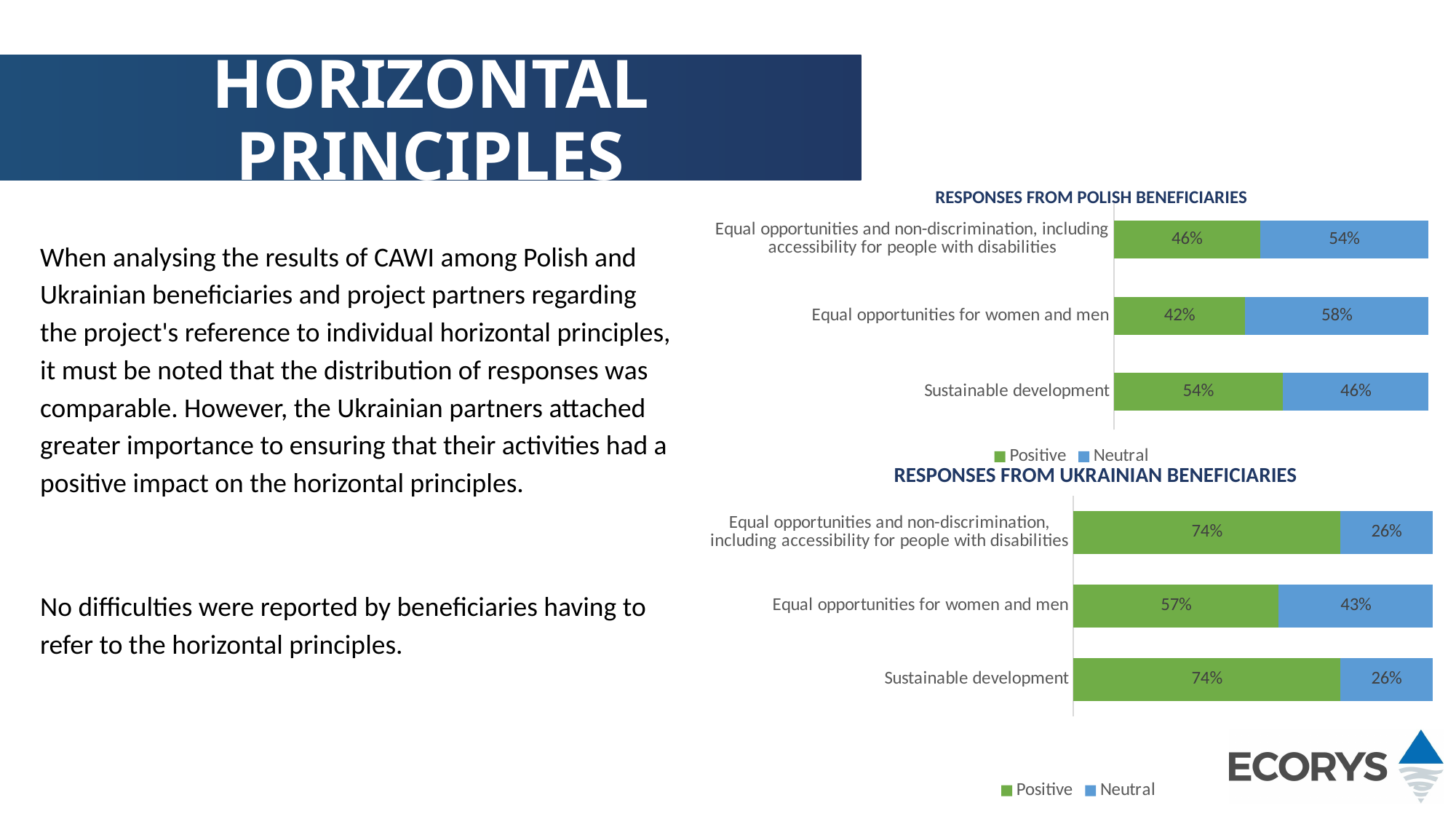
How many categories are shown in the 'Responses from Polish beneficiaries' chart? 3 In the 'Responses from Polish beneficiaries' chart, which category has the highest Positive value? Sustainable development How many series does the legend of the 'Responses from Ukrainian beneficiaries' chart list? 2 In the 'Responses from Polish beneficiaries' chart, what is the Positive value for Sustainable development? 54% In the 'Responses from Ukrainian beneficiaries' chart, which category has the lowest Positive value? Equal opportunities for women and men What kind of chart is the 'Responses from Polish beneficiaries' chart? Stacked bar chart In the 'Responses from Ukrainian beneficiaries' chart, what is the Positive value for Equal opportunities for women and men? 57% In the 'Responses from Ukrainian beneficiaries' chart, what is the Neutral value for Sustainable development? 26% In the 'Responses from Ukrainian beneficiaries' chart, what is the difference between the Positive and Neutral values for Sustainable development? 48% In the 'Responses from Polish beneficiaries' chart, what is the difference between the Neutral and Positive values for Equal opportunities for women and men? 16% In the 'Responses from Polish beneficiaries' chart, what is the Neutral value for Equal opportunities for women and men? 58% Is the Positive value for Sustainable development larger in the 'Responses from Polish beneficiaries' chart or the 'Responses from Ukrainian beneficiaries' chart? Responses from Ukrainian beneficiaries